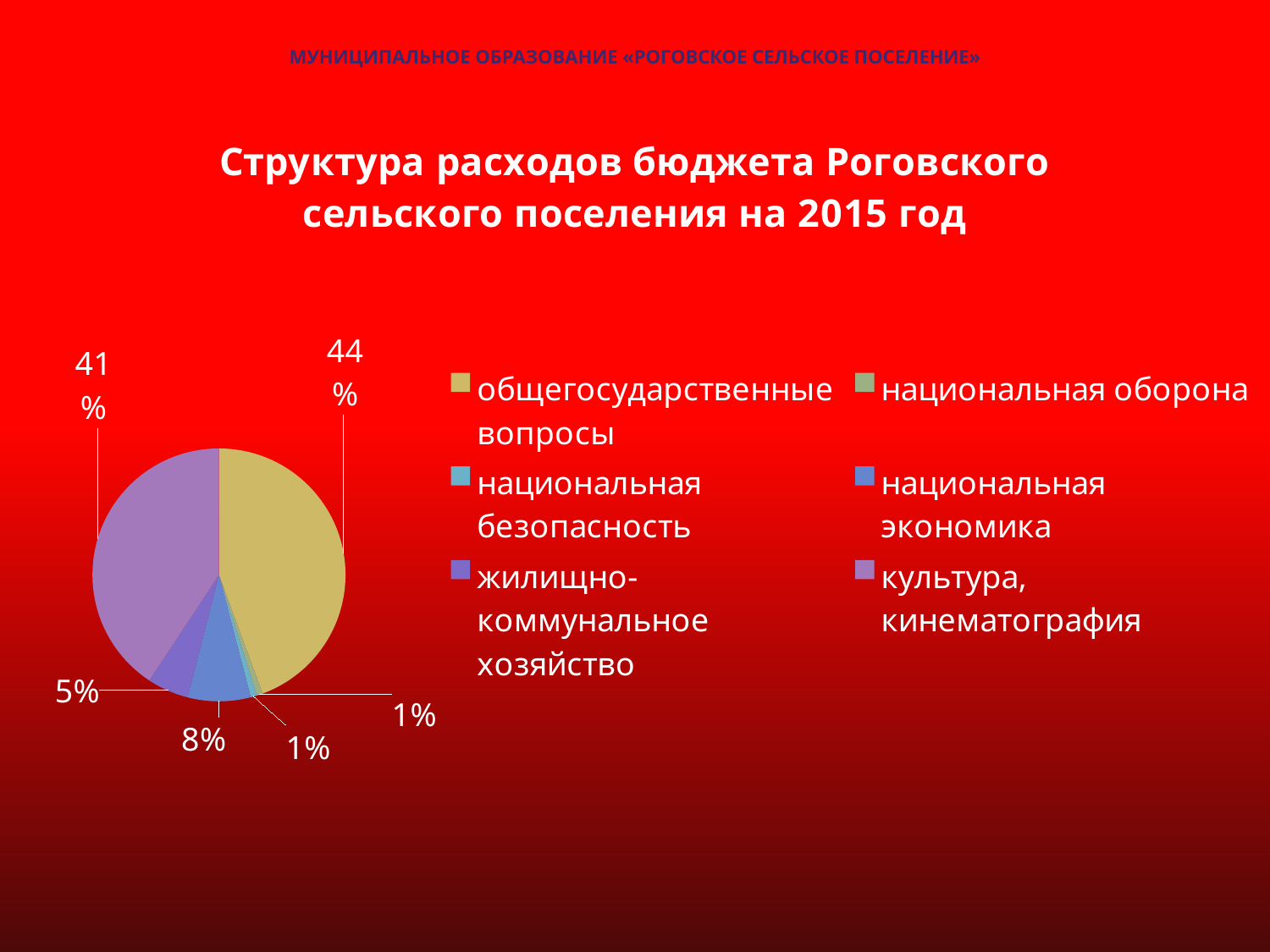
What share of the budget expenditure goes to национальная оборона? 1% What share of the budget expenditure goes to общегосударственные вопросы? 44% What is the difference in percentage points between национальная экономика and жилищно-коммунальное хозяйство? 3 percentage points What share of the budget expenditure goes to национальная экономика? 8% Which category has the largest share of the budget expenditure? общегосударственные вопросы What is the title of the chart? Структура расходов бюджета Роговского сельского поселения на 2015 год How many categories does the pie chart show? 6 What is the difference in percentage points between общегосударственные вопросы and культура, кинематография? 3 percentage points Which is larger: the share for национальная экономика or the share for жилищно-коммунальное хозяйство? национальная экономика What type of chart is shown on the slide? pie chart